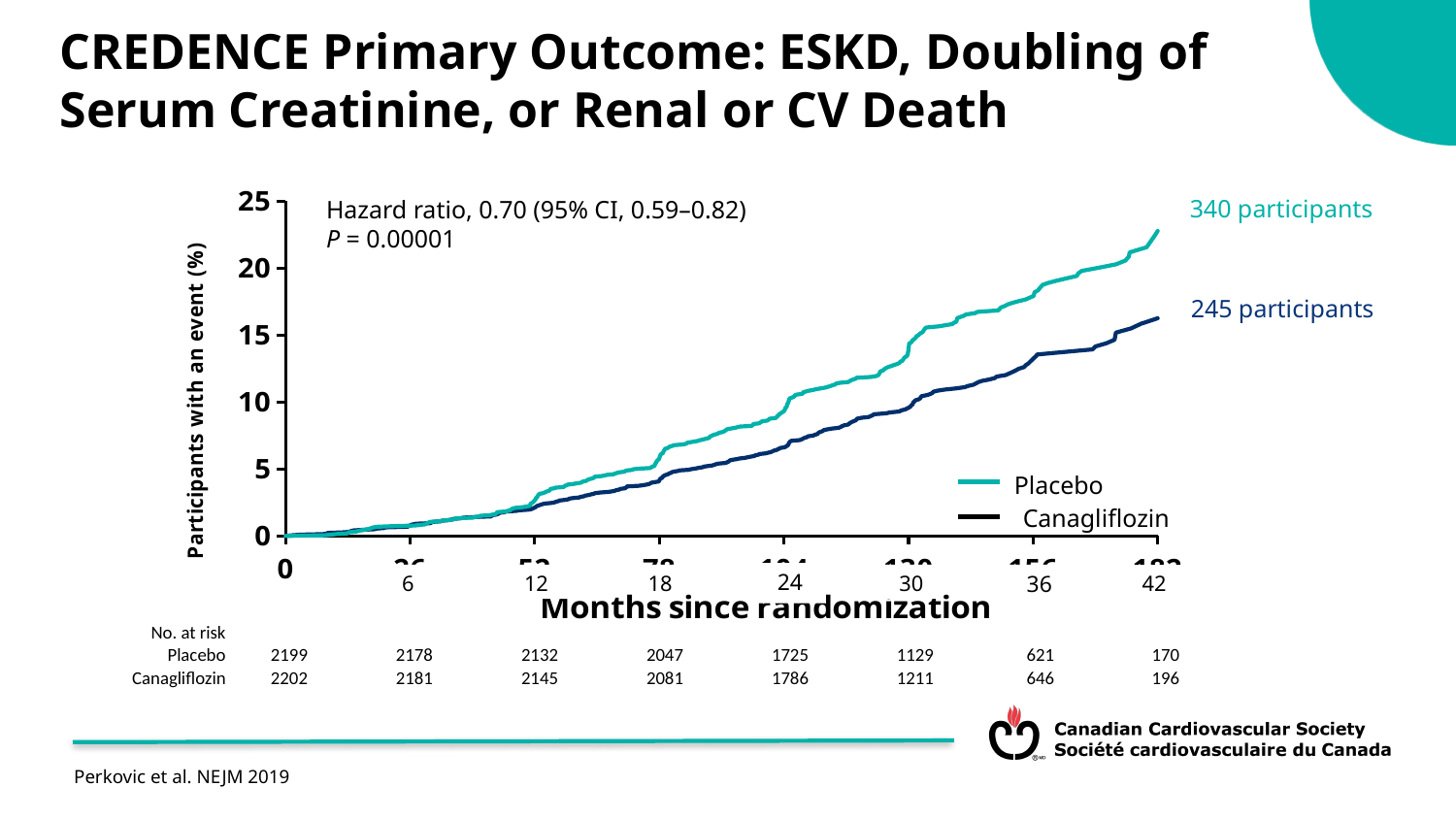
Is the value for Placebo at 42 months greater or less than 20%? greater Which series has the higher percentage of participants with an event at 42 months, Placebo or Canagliflozin? Placebo What is the difference between the number of participants with an event in the Placebo group and the Canagliflozin group? 95 Is the value for Canagliflozin at 42 months greater or less than 20%? less How many participants had an event in the Placebo group, as annotated on the chart? 340 participants Do the curves rise or fall as months since randomization increase? Rise Is the value for Canagliflozin at 24 months greater or less than 10%? less What kind of chart is shown on the slide? Line chart How many participants had an event in the Canagliflozin group, as annotated on the chart? 245 participants Which two series are listed in the chart legend? Placebo and Canagliflozin How many series does the legend list? 2 What is the label of the y axis? Participants with an event (%)